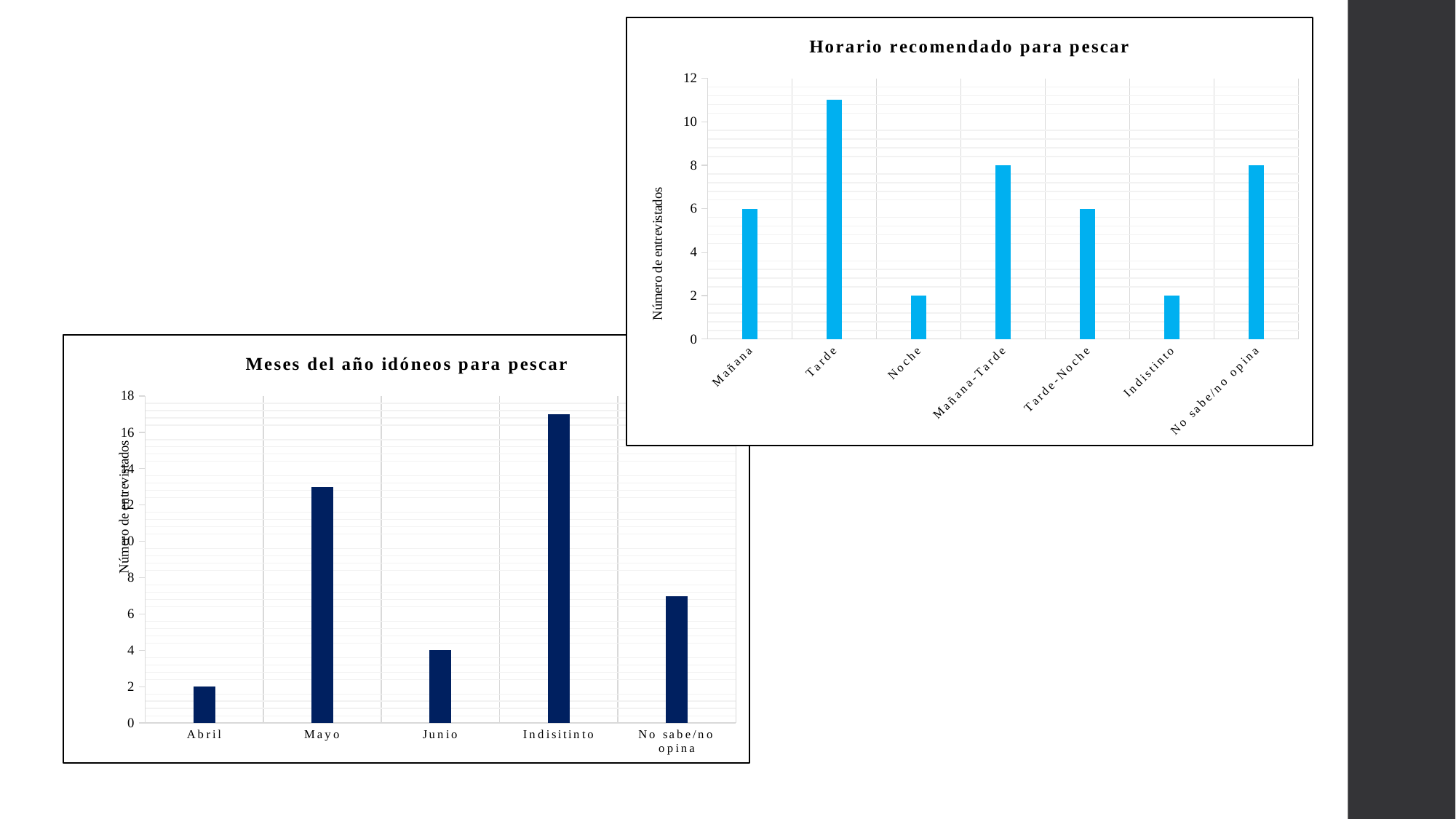
In the 'Meses del año idóneos para pescar' chart, which category has the lowest value? Abril In the 'Meses del año idóneos para pescar' chart, which category has the highest value? Indisitinto In the 'Horario recomendado para pescar' chart, is the value for Tarde greater or less than 10? greater In the 'Meses del año idóneos para pescar' chart, which is larger, Mayo or No sabe/no opina? Mayo In the 'Horario recomendado para pescar' chart, what is the difference between Mañana-Tarde and Noche? 6 In the 'Horario recomendado para pescar' chart, how many categories are shown on the x axis? 7 In the 'Meses del año idóneos para pescar' chart, is the value for Mayo greater or less than 12? greater In the 'Meses del año idóneos para pescar' chart, what is the value for Junio? 4 In the 'Horario recomendado para pescar' chart, which category has the highest value? Tarde What kind of chart is 'Meses del año idóneos para pescar'? Bar chart In the 'Horario recomendado para pescar' chart, what is the value for Mañana? 6 In the 'Horario recomendado para pescar' chart, what is the value for Mañana-Tarde? 8